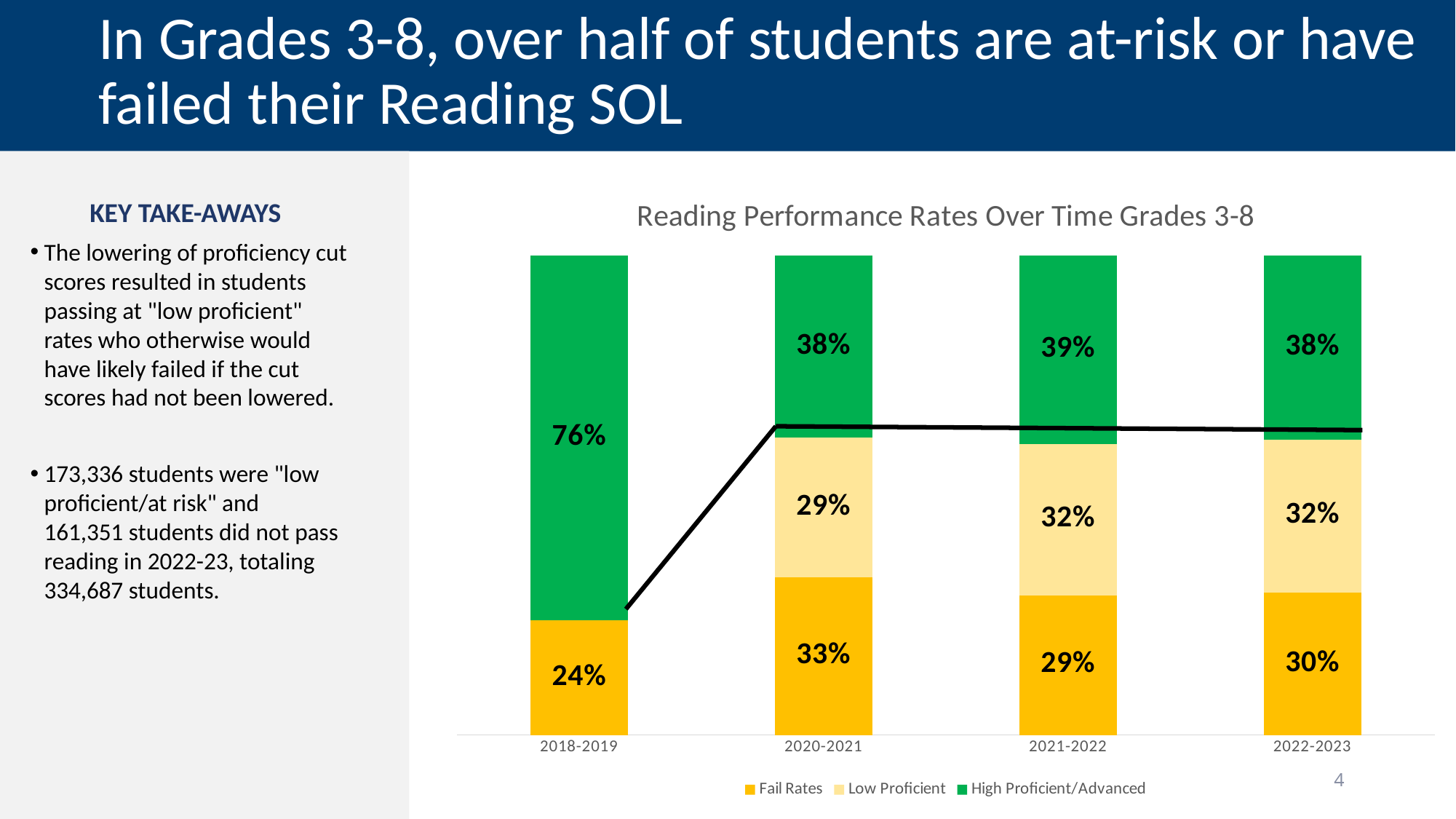
What kind of chart is shown? Stacked bar chart What is the High Proficient/Advanced value for 2021-2022? 39% What is the Low Proficient value for 2020-2021? 29% What is the title of the chart? Reading Performance Rates Over Time Grades 3-8 Is the Fail Rates value larger in 2020-2021 or in 2022-2023? 2020-2021 What is the combined Fail Rates and Low Proficient share for 2022-2023? 62% Which year has the lowest Fail Rates value? 2018-2019 How many years are shown on the x axis? 4 What is the difference between the High Proficient/Advanced value in 2018-2019 and in 2020-2021? 38% Which year has the highest Fail Rates value? 2020-2021 How many series does the legend list? 3 What is the Fail Rates value for 2018-2019? 24%